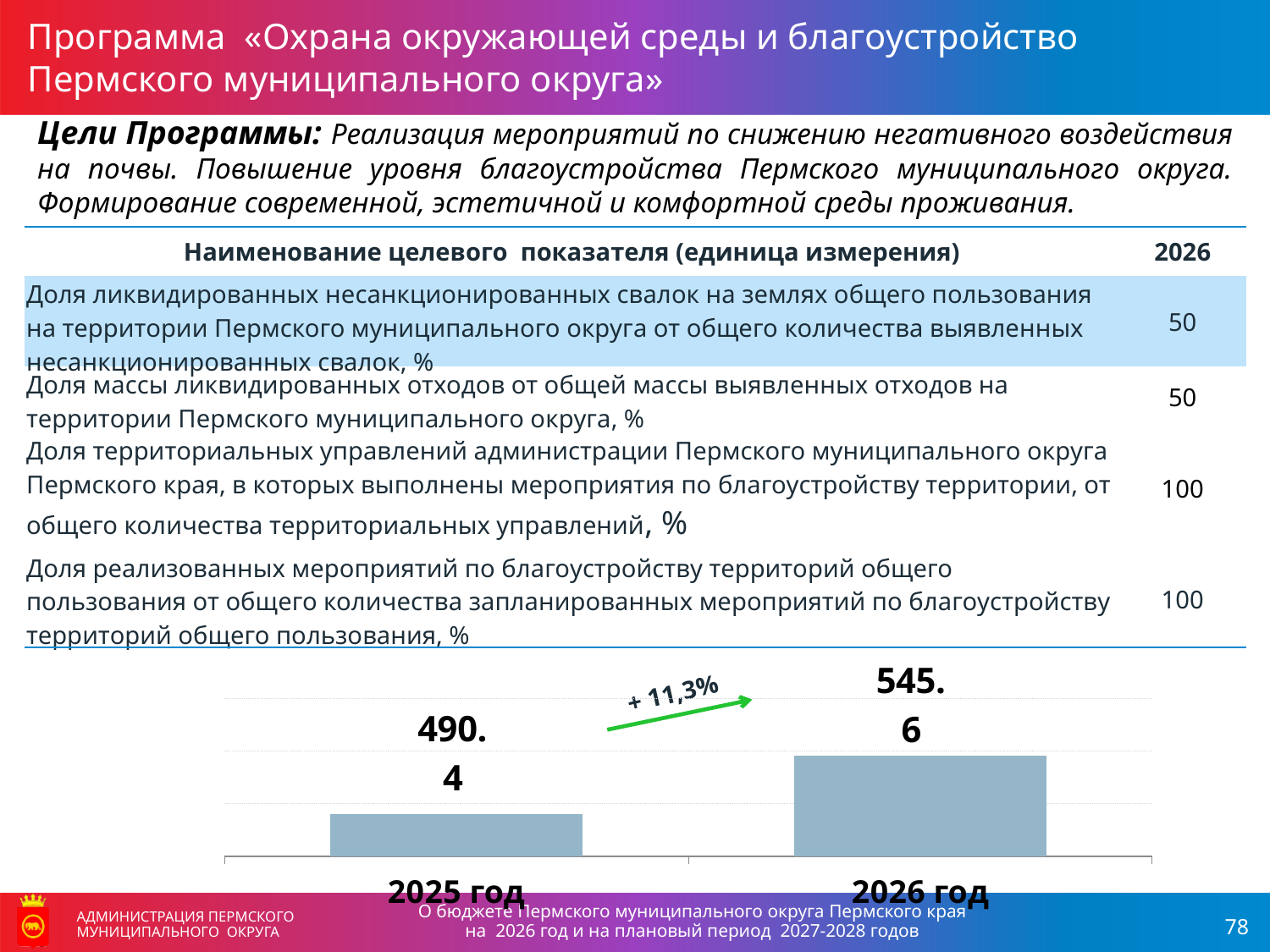
Do the values in the bar chart rise or fall from 2025 год to 2026 год? Rise Which year has the highest bar in the chart? 2026 год Which is larger in the bar chart: the value for 2025 год or for 2026 год? 2026 год What is the difference between the values for 2026 год and 2025 год in the bar chart? 55.2 What is the value shown for 2026 год in the bar chart? 545.6 What is the value shown for 2025 год in the bar chart? 490.4 Which year has the lowest bar in the chart? 2025 год What percentage change is written next to the arrow between the two bars? + 11,3% What kind of chart is shown at the bottom of the slide? Bar chart What are the two category labels on the x axis of the bar chart? 2025 год and 2026 год How many bars are plotted in the chart? 2